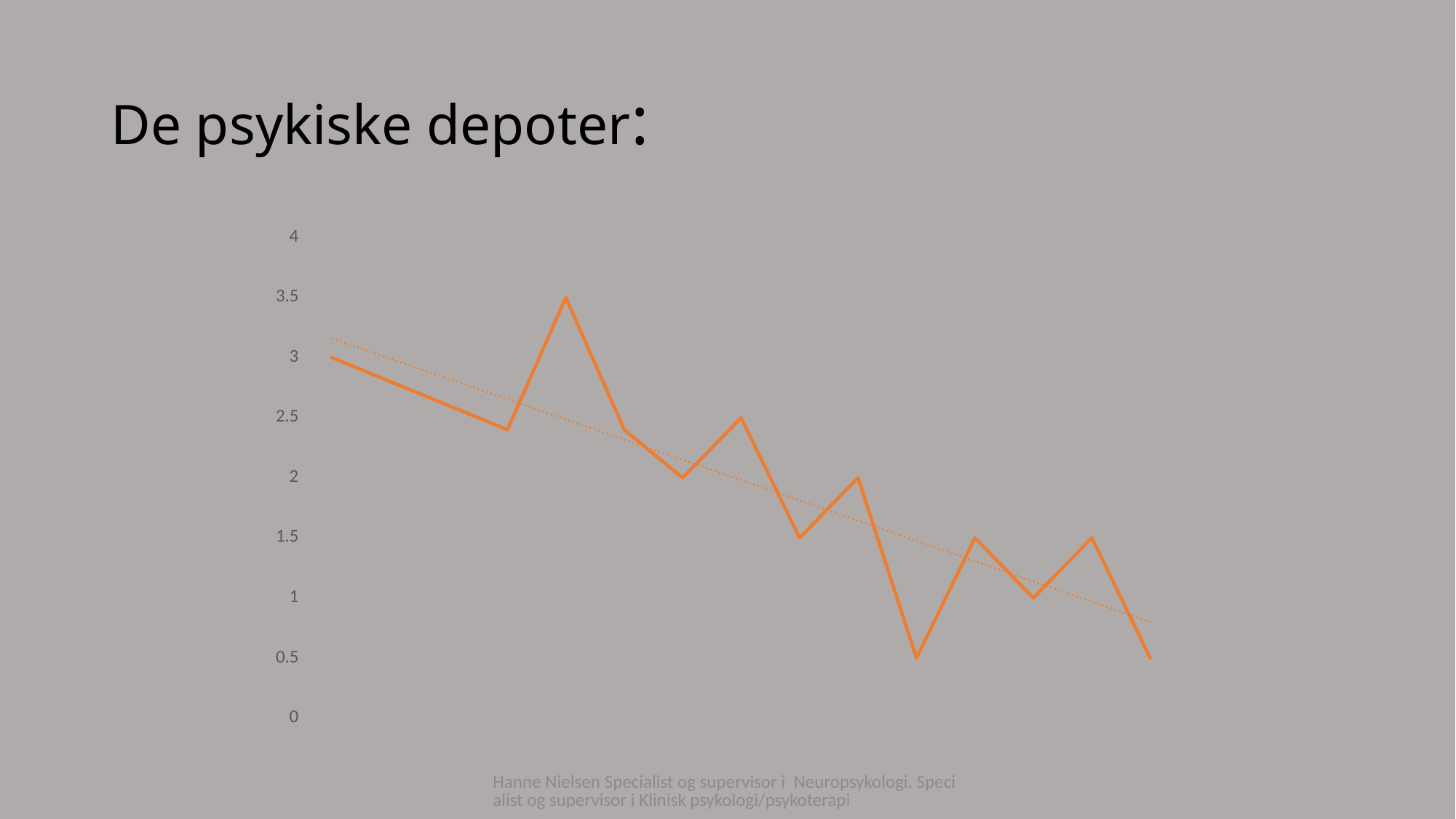
What is the highest value reached by the solid line? 3.5 Is the last point of the solid line greater or less than 1? less Is the first point of the solid line greater or less than 2.5? greater What is the title of the slide containing the chart? De psykiske depoter: What is the lowest value reached by the solid line? 0.5 What is the highest tick value shown on the vertical axis? 4 What kind of chart is shown on the slide? line chart Does the chart include a dotted trendline in addition to the solid data line? yes Is the peak of the solid line greater or less than 3? greater Do the values of the solid line generally rise or fall from left to right? fall